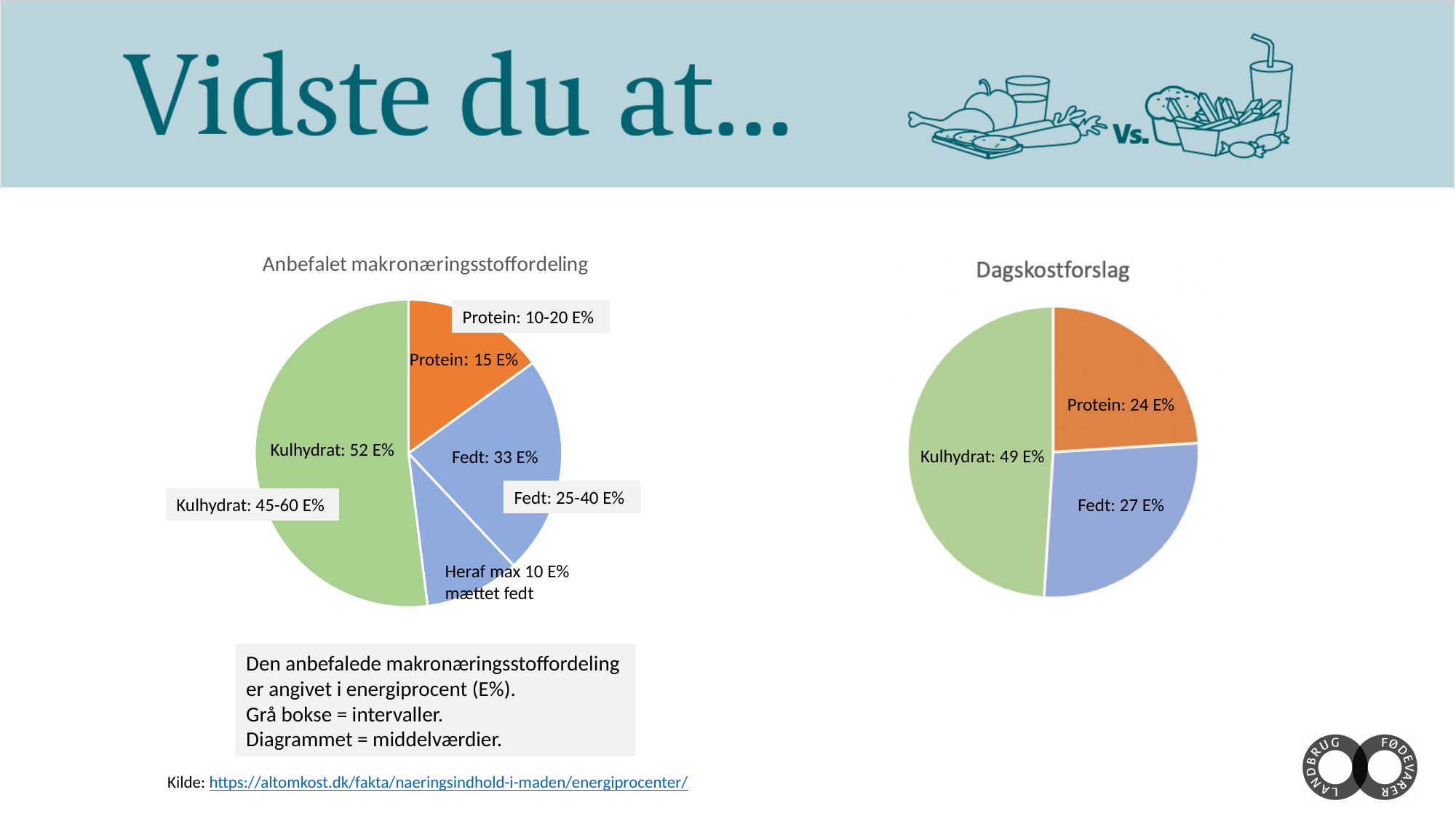
In the 'Anbefalet makronæringsstoffordeling' chart, what is the difference between Kulhydrat and Fedt? 19 E% In the 'Dagskostforslag' chart, which category has the largest slice? Kulhydrat In the 'Dagskostforslag' chart, what is the value for Protein? 24 E% In the 'Anbefalet makronæringsstoffordeling' chart, what is the value for Fedt? 33 E% How many categories are labelled in the 'Dagskostforslag' chart? 3 In the 'Dagskostforslag' chart, which is larger, Protein or Fedt? Fedt In the 'Anbefalet makronæringsstoffordeling' chart, what interval is shown in the grey box for Fedt? 25-40 E% In the 'Anbefalet makronæringsstoffordeling' chart, what is the value for Kulhydrat? 52 E% What type of chart is 'Dagskostforslag'? Pie chart In the 'Dagskostforslag' chart, what is the value for Fedt? 27 E% What is the difference between the Protein value in the 'Dagskostforslag' chart and the Protein value in the 'Anbefalet makronæringsstoffordeling' chart? 9 E%